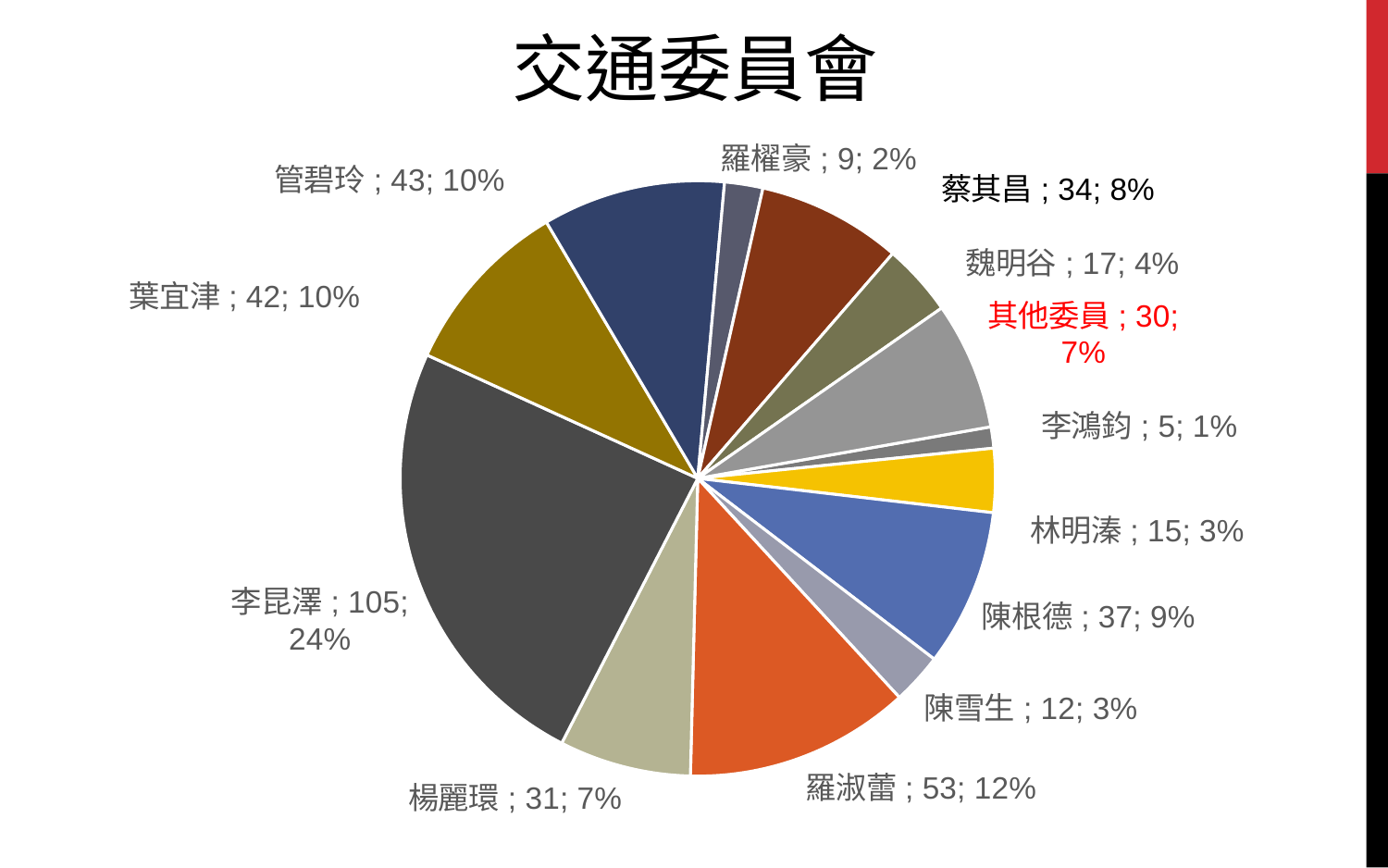
What percentage share does 其他委員 have? 7% What is the title of the chart? 交通委員會 What kind of chart is shown on the slide? pie chart Which category has the smallest slice? 李鴻鈞 Which is larger, the value for 蔡其昌 or the value for 魏明谷? 蔡其昌 What is the value for 李昆澤? 105 What is the difference between the values for 李昆澤 and 羅淑蕾? 52 What is the value for 羅淑蕾? 53 What is the value for 陳根德? 37 How many slices does the pie chart have? 13 Which category has the largest slice? 李昆澤 What percentage share does 管碧玲 have? 10%